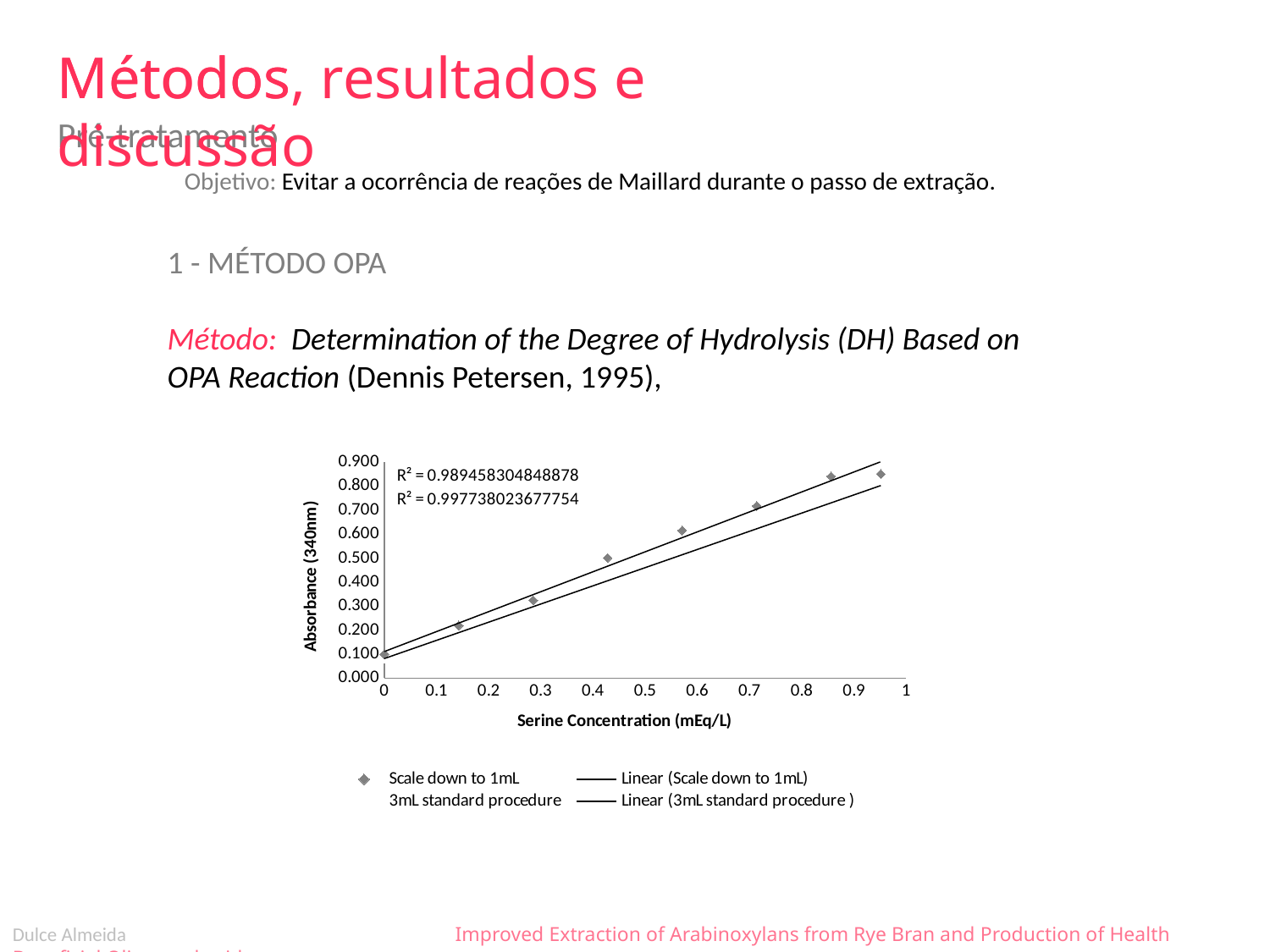
Is the absorbance of the diamond data point near a serine concentration of 0.57 mEq/L greater or less than 0.500? greater How many entries does the chart legend list? 4 What kind of chart is shown on the slide? Scatter chart Is the absorbance of the diamond data point near a serine concentration of 0.29 mEq/L greater or less than 0.400? less Do the absorbance values rise or fall as serine concentration increases along the x axis? Rise Which diamond data point has the lowest absorbance: the one at serine concentration 0 or the one near 0.71 mEq/L? The one at 0 What is the title of the y axis of the chart? Absorbance (340nm) How many diamond data points are plotted for the 'Scale down to 1mL' series? 8 What is the first R² value printed on the chart? R² = 0.989458304848878 Is the absorbance of the diamond data point near a serine concentration of 0.43 mEq/L greater or less than 0.400? greater What is the second R² value printed on the chart? R² = 0.997738023677754 What is the title of the x axis of the chart? Serine Concentration (mEq/L)